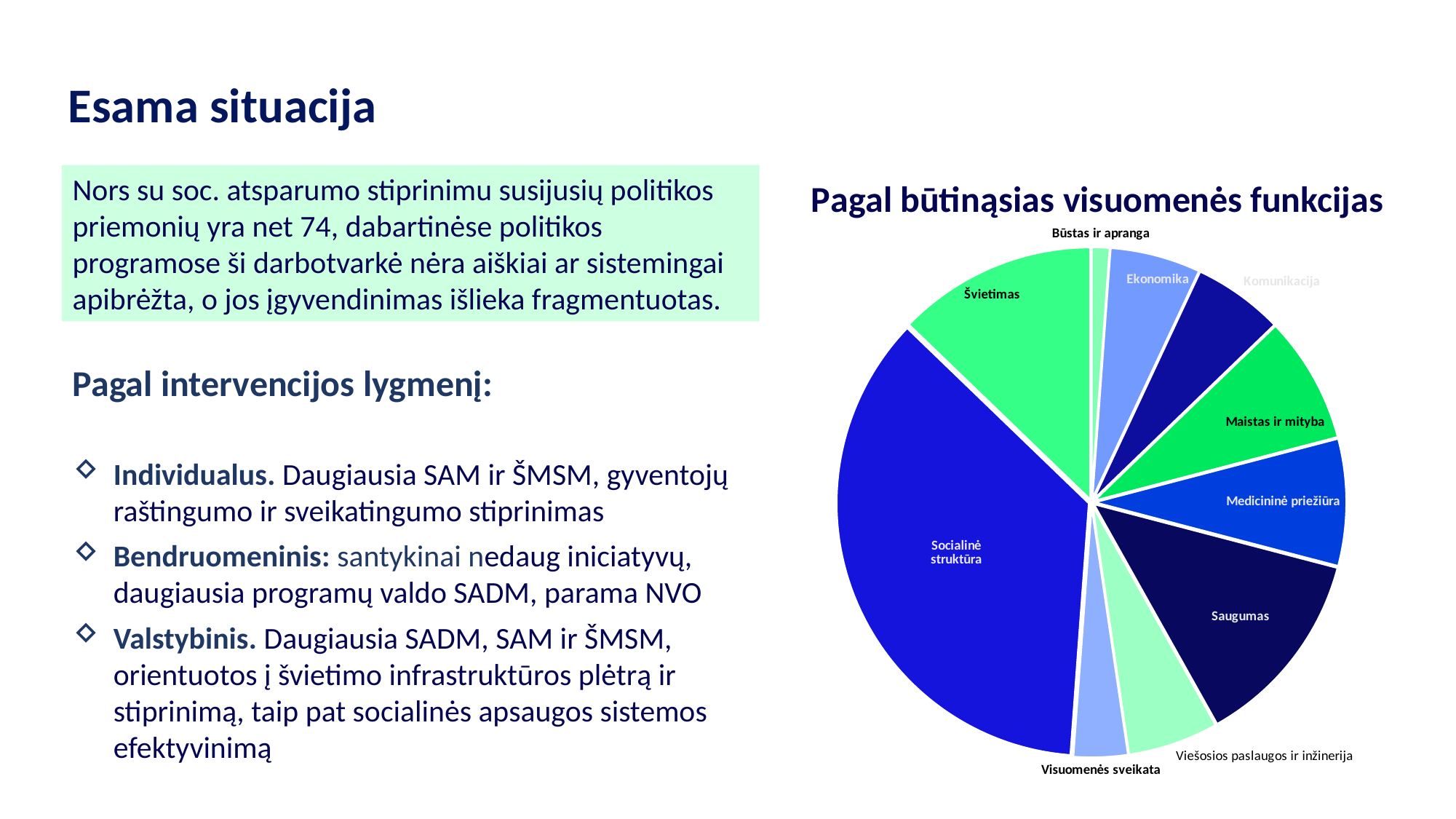
What kind of chart is shown on the slide? pie chart What colour is the Švietimas slice? green Which slice is larger, Maistas ir mityba or Ekonomika? Maistas ir mityba Which slice is larger, Viešosios paslaugos ir inžinerija or Visuomenės sveikata? Viešosios paslaugos ir inžinerija Which slice is larger, Saugumas or Medicininė priežiūra? Saugumas Does the Socialinė struktūra slice take up more or less than half of the pie? less What is the title of the pie chart? Pagal būtinąsias visuomenės funkcijas Which category has the largest slice in the pie chart? Socialinė struktūra Which labelled category has the smallest slice in the pie chart? Būstas ir apranga